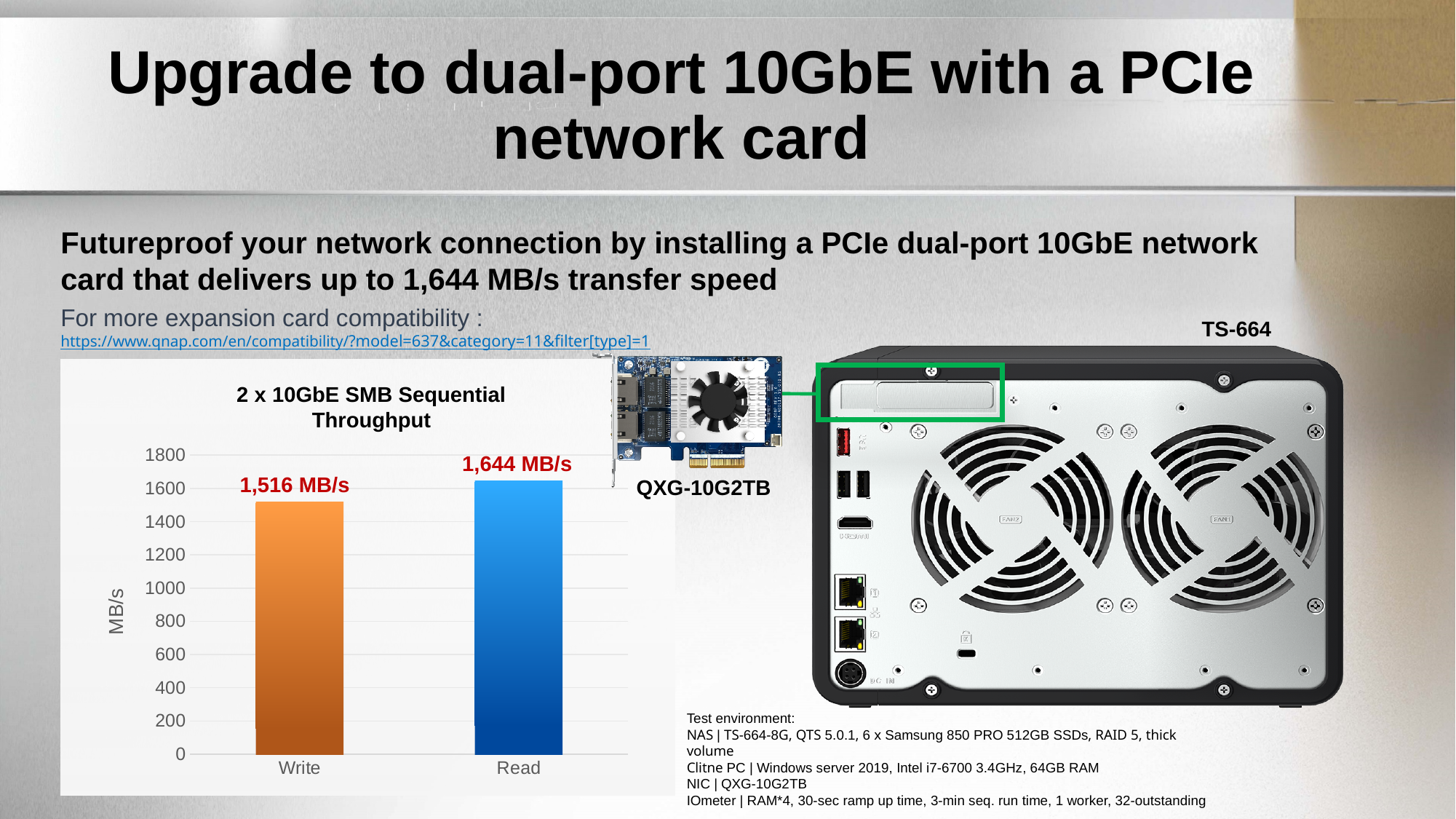
What is the label on the vertical axis of the chart? MB/s How many categories are shown in the chart? 2 What kind of chart is shown on the slide? bar chart Which category has the lowest value in the chart? Write What is the difference between the Read and Write values in the chart? 128 MB/s What is the title of the chart? 2 x 10GbE SMB Sequential Throughput Which category has the highest value in the chart? Read Is the value for Read greater or less than 1800? less Is the value for Write greater or less than 1400? greater What is the value for Write in the chart? 1,516 MB/s What is the value for Read in the chart? 1,644 MB/s Which is larger in the chart, Write or Read? Read